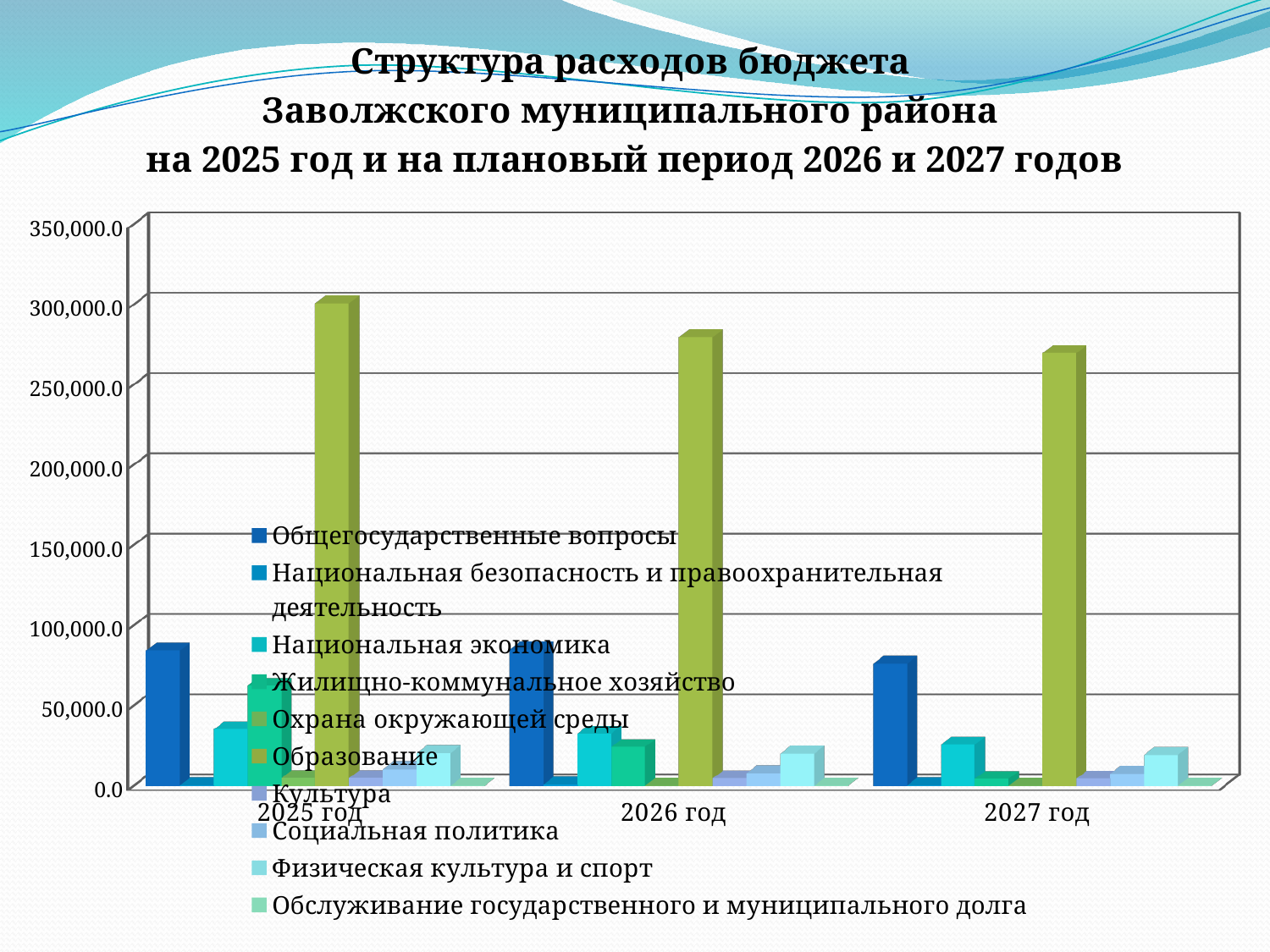
Is the value for Общегосударственные вопросы in 2025 год greater or less than 100,000.0? less In 2026 год, which is larger: Образование or Общегосударственные вопросы? Образование What kind of chart is shown on the slide? bar chart In which year is the bar for Образование the highest? 2025 год Which series has the tallest bar in 2025 год? Образование Is the value for Образование in 2026 год greater or less than 300,000.0? less How many series does the legend list? 10 How many year categories are shown on the x axis? 3 Does the value for Образование rise or fall from 2025 год to 2027 год? fall Which series is listed first in the legend? Общегосударственные вопросы Is the value for Образование in 2027 год greater or less than 300,000.0? less